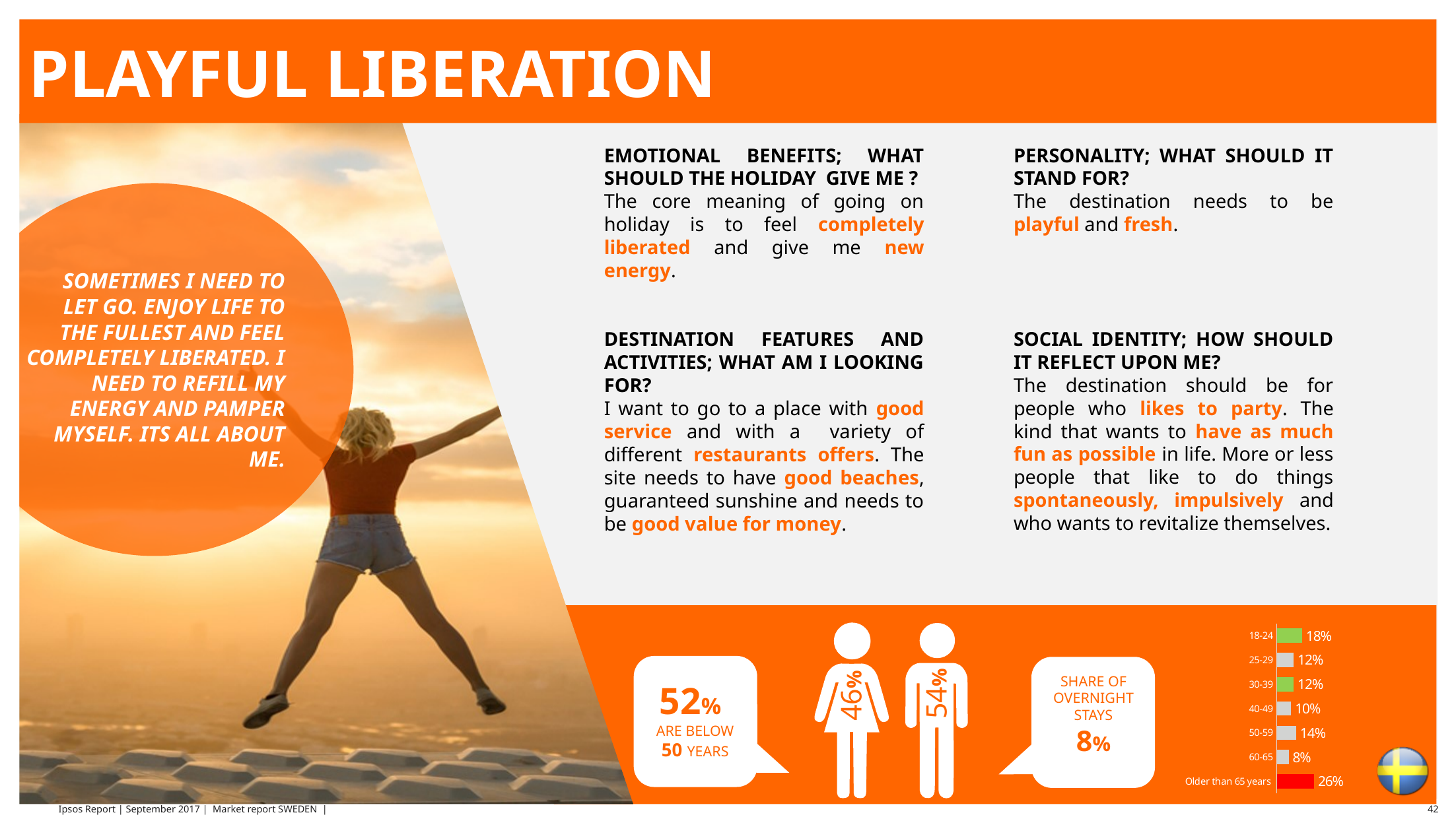
According to the slide, what percentage of this segment are below 50 years? 52% In the age-group bar chart, what is the value for the 50-59 group? 14% What kind of chart is used to show the age-group distribution on the slide? Bar chart In the age-group bar chart, what is the difference between the Older than 65 years group and the 18-24 group? 8% How many age groups are shown in the age-group bar chart? 7 In the age-group bar chart, what is the value for the 18-24 group? 18% In the age-group bar chart, which age group has the lowest value? 60-65 In the age-group bar chart, what colour is the bar for Older than 65 years? Red In the age-group bar chart, what is the value for the 60-65 group? 8% In the age-group bar chart, which is larger: the value for 40-49 or the value for 50-59? 50-59 In the age-group bar chart, which age group has the highest value? Older than 65 years According to the slide, what is the share of overnight stays for this segment? 8%